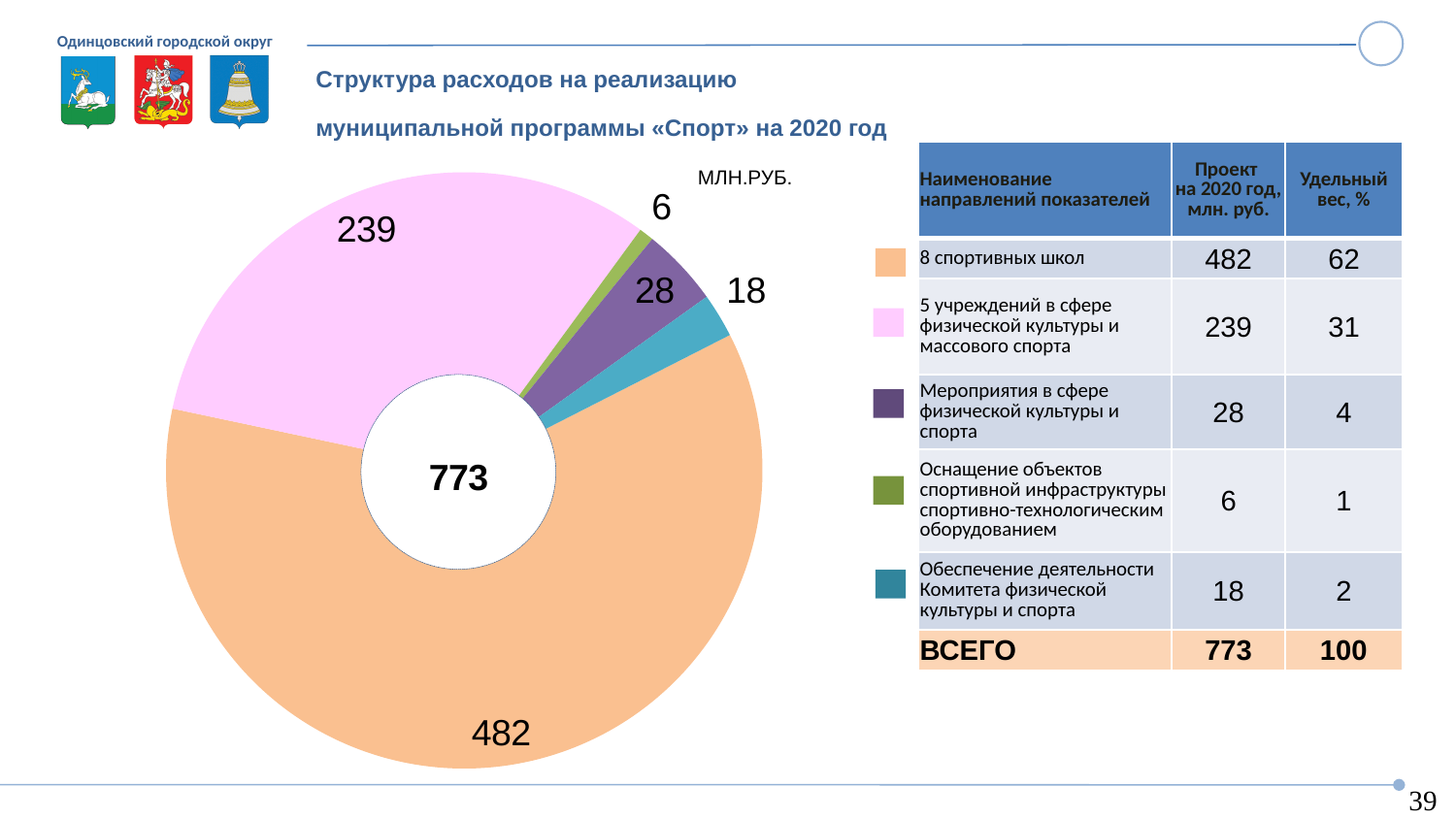
How many slices does the chart have? 5 Which category has the largest slice of the chart? 8 спортивных школ What is the value for "8 спортивных школ" in the chart? 482 What is the difference between the values for "8 спортивных школ" and "5 учреждений в сфере физической культуры и массового спорта"? 243 What total value is shown in the centre of the chart? 773 What share of the total does "8 спортивных школ" represent, as shown in the table? 62% What is the value for "Мероприятия в сфере физической культуры и спорта"? 28 Which category has the smallest slice of the chart? Оснащение объектов спортивной инфраструктуры спортивно-технологическим оборудованием What is the value for "Обеспечение деятельности Комитета физической культуры и спорта"? 18 Which is larger: the value for "Мероприятия в сфере физической культуры и спорта" or for "Обеспечение деятельности Комитета физической культуры и спорта"? Мероприятия в сфере физической культуры и спорта What kind of chart is shown on the slide? Pie (doughnut) chart What is the value for "5 учреждений в сфере физической культуры и массового спорта"? 239